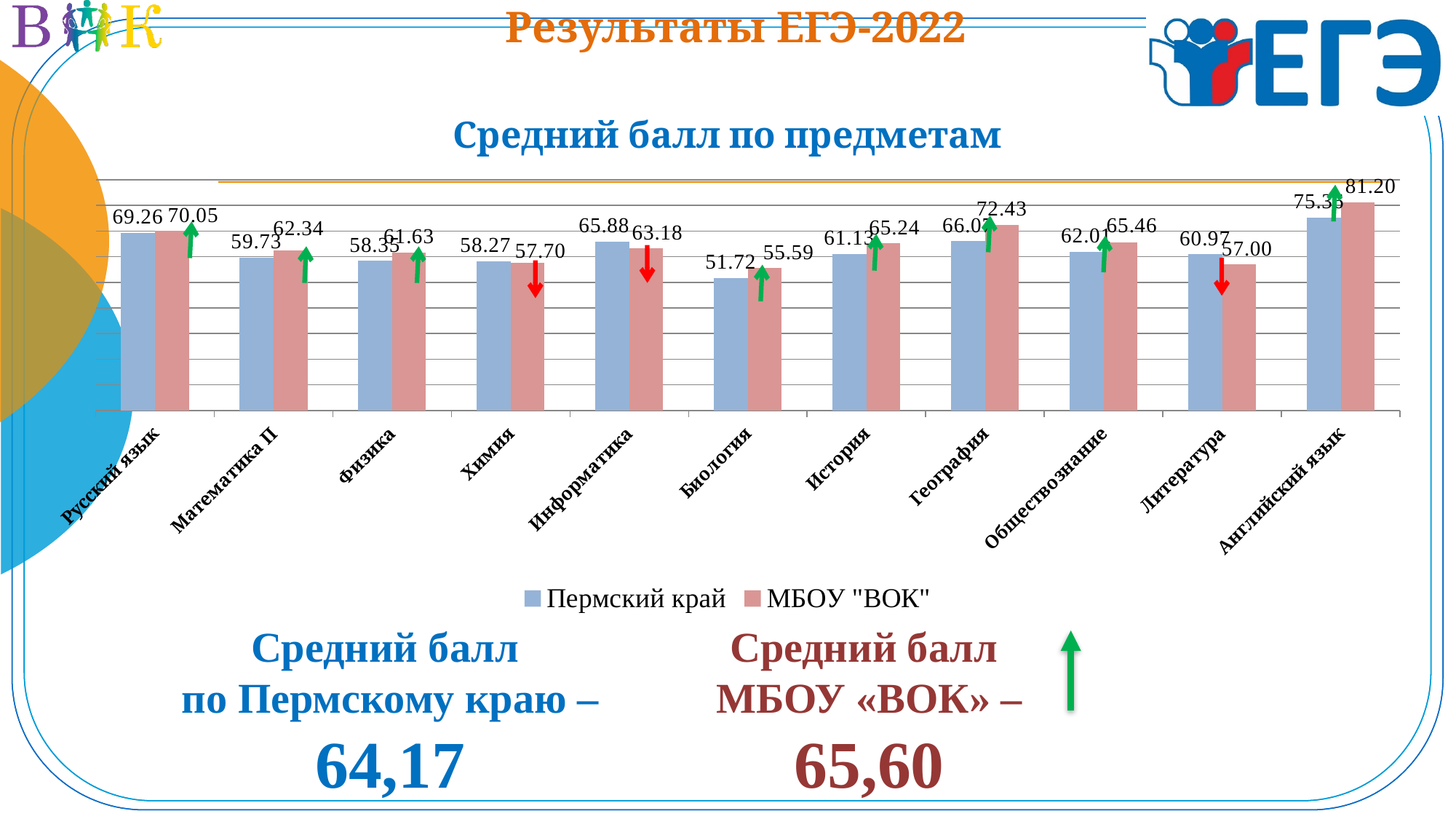
What is the value for МБОУ "ВОК" in Химия? 57.70 In Физика, what is the difference between the МБОУ "ВОК" value and the Пермский край value? 3.28 Which subject has the highest value for МБОУ "ВОК"? Английский язык How many series does the chart legend list? 2 What is the value for Пермский край in Русский язык? 69.26 In Информатика, which series has the larger value, Пермский край or МБОУ "ВОК"? Пермский край Which subject has the lowest value for Пермский край? Биология How many subjects are shown on the x axis of the chart? 11 What is the value for МБОУ "ВОК" in Литература? 57.00 In Математика П, how much higher is the МБОУ "ВОК" value than the Пермский край value? 2.61 What type of chart is shown on the slide? bar chart What is the value for МБОУ "ВОК" in Биология? 55.59